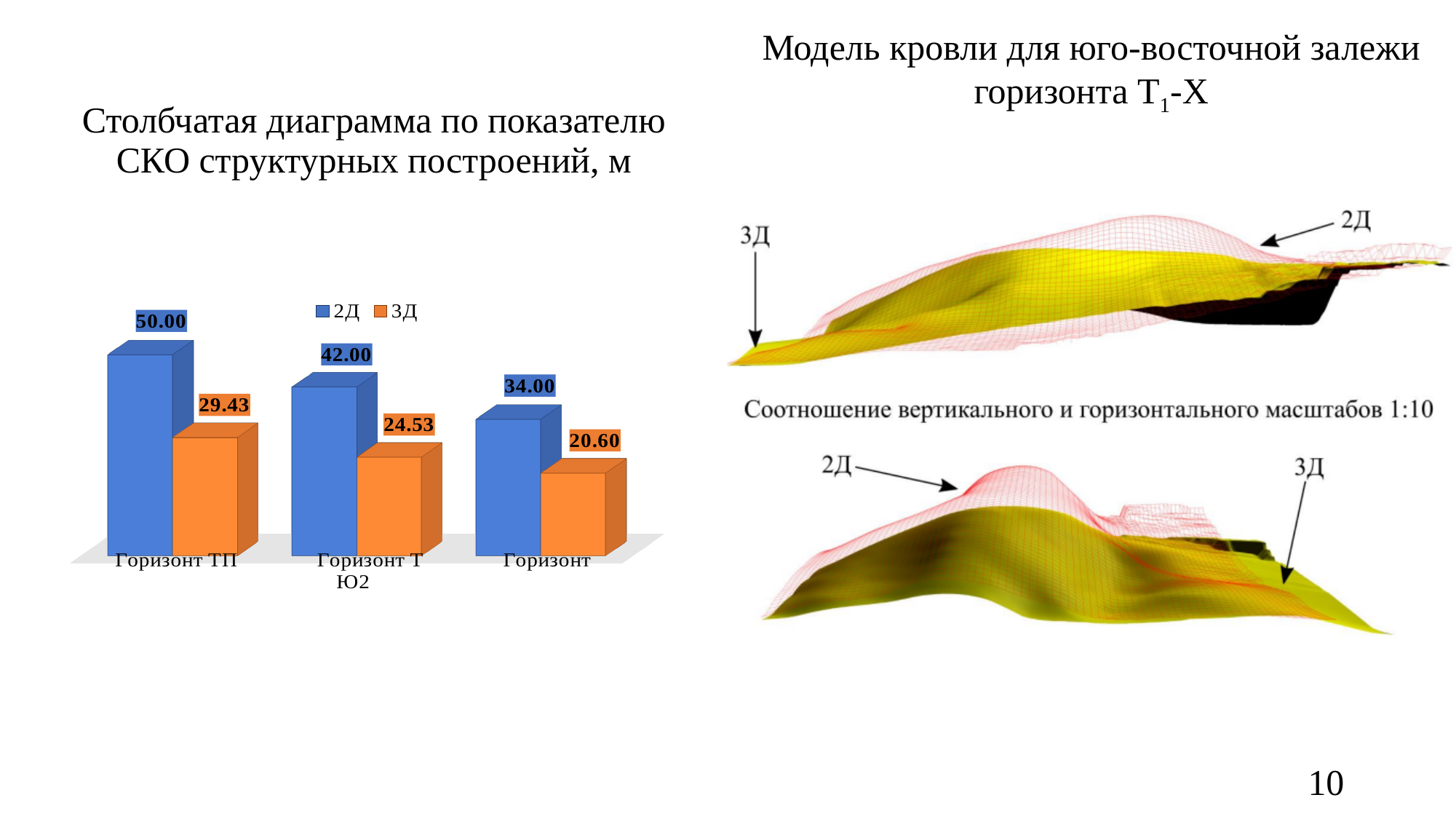
How many categories are shown on the bar chart? 3 What kind of chart is shown on the left of the slide? Bar chart Which category has the highest 2Д value? Горизонт ТП Do the 3Д values rise or fall from left to right across the categories? Fall What is the difference between the 2Д and 3Д values for Горизонт ТП? 20.57 What is the 3Д value for Горизонт ТП? 29.43 What is the 2Д value for Горизонт ТП? 50.00 How many series does the legend of the bar chart list? 2